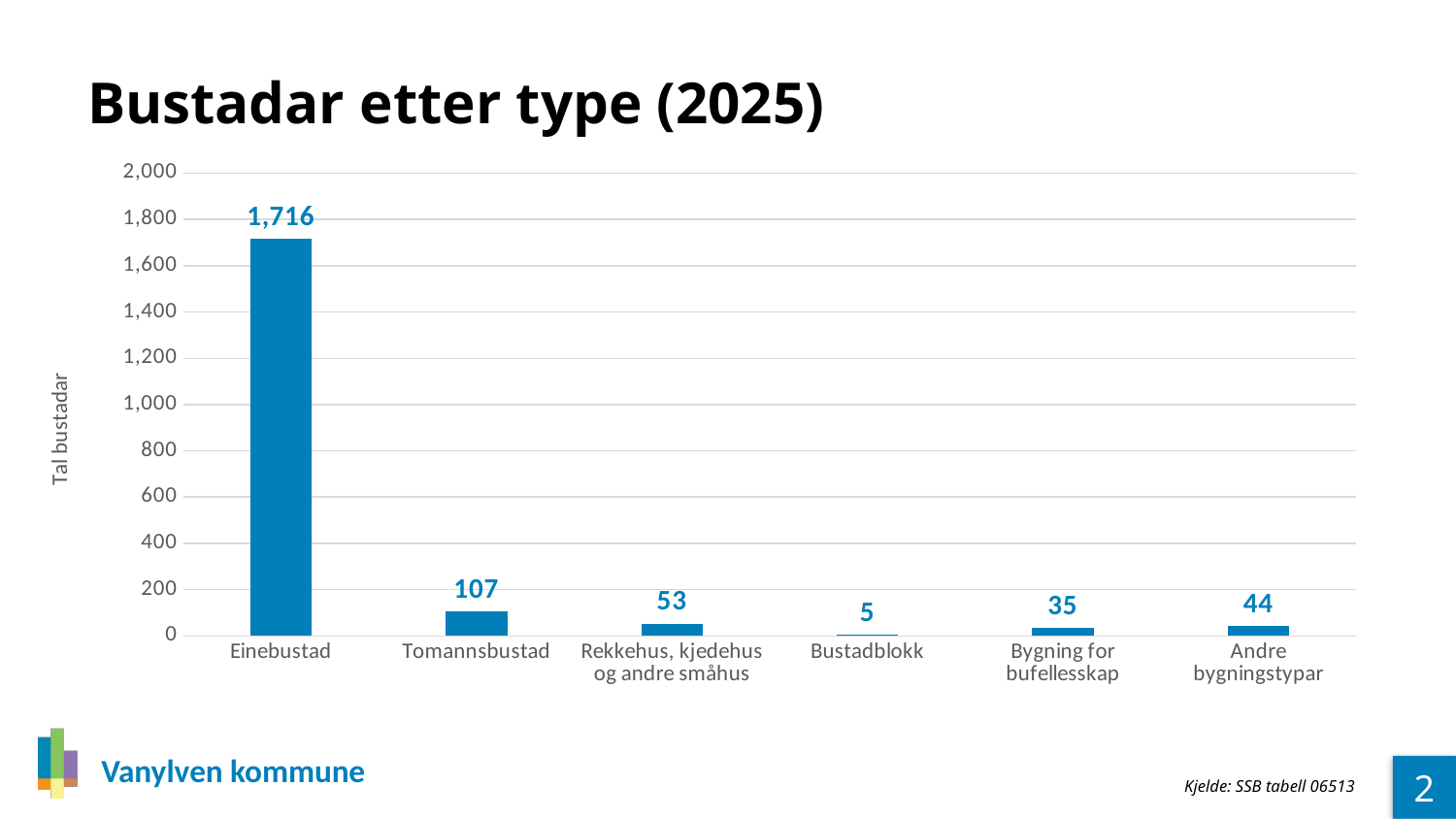
What kind of chart is shown on the slide? Bar chart Is the value for Einebustad greater or less than 1,600? greater Which is larger, the value for Bygning for bufellesskap or the value for Andre bygningstypar? Andre bygningstypar What is the value for Bustadblokk? 5 What is the title of the chart? Bustadar etter type (2025) What is the value for Einebustad? 1,716 What is the value for Andre bygningstypar? 44 How many categories are shown on the x axis? 6 Which category has the lowest value? Bustadblokk What is the value for Tomannsbustad? 107 Which category has the highest value? Einebustad What is the difference between the values for Tomannsbustad and Rekkehus, kjedehus og andre småhus? 54